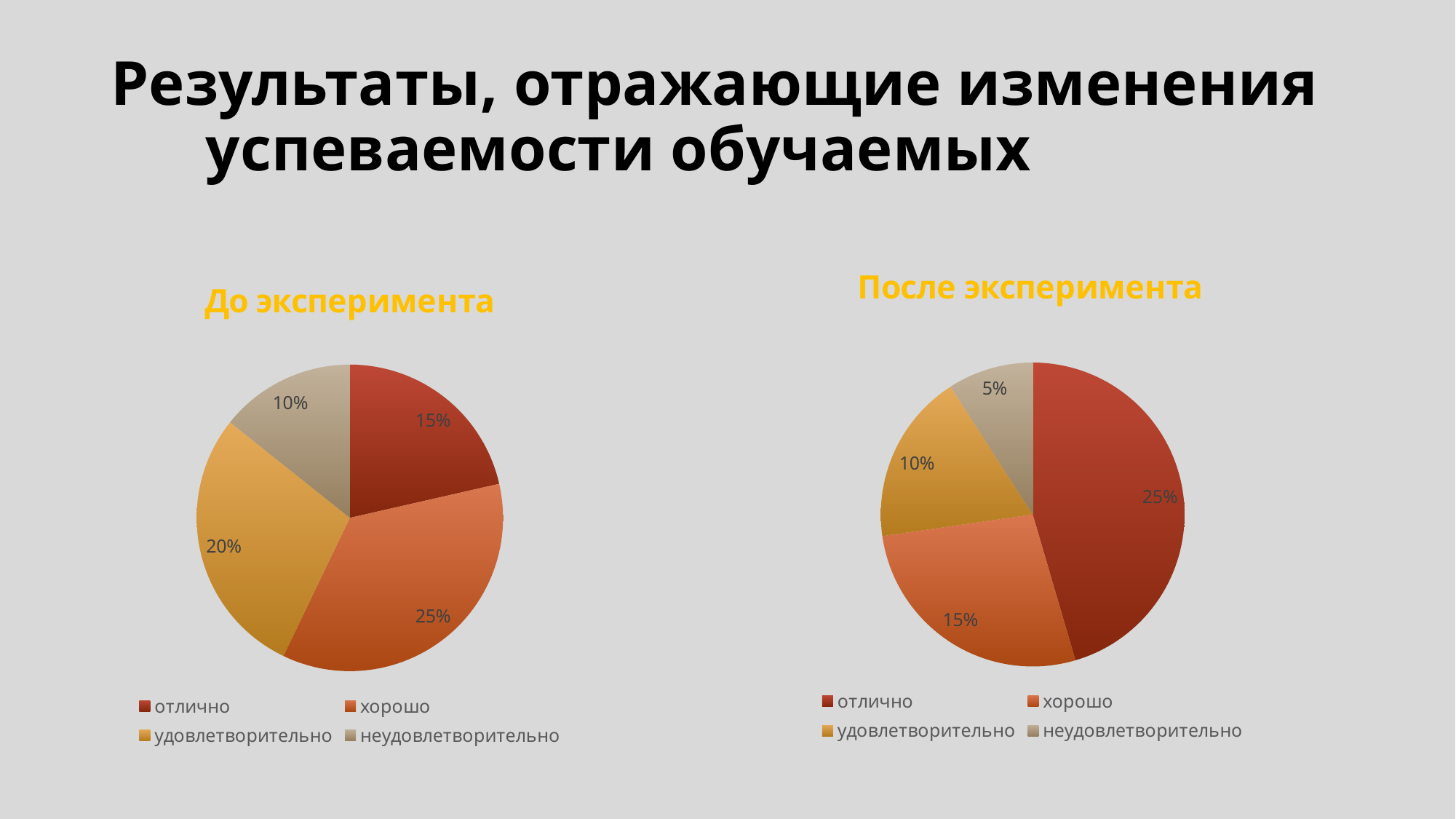
In the 'После эксперимента' chart, what is the difference between the values for 'отлично' and 'хорошо'? 10% What is the title of the chart on the right side of the slide? После эксперимента In the 'До эксперимента' chart, what value is shown for 'отлично'? 15% In the 'После эксперимента' chart, what value is shown for 'отлично'? 25% In the 'После эксперимента' chart, what value is shown for 'неудовлетворительно'? 5% In the 'До эксперимента' chart, which category has the largest slice? хорошо How many categories does the 'После эксперимента' chart show? 4 What type of chart is the 'До эксперимента' chart? pie chart In the 'После эксперимента' chart, which category has the smallest slice? неудовлетворительно In the 'До эксперимента' chart, what value is shown for 'хорошо'? 25% In the 'До эксперимента' chart, which is larger: 'удовлетворительно' or 'отлично'? удовлетворительно In the 'До эксперимента' chart, what value is shown for 'неудовлетворительно'? 10%